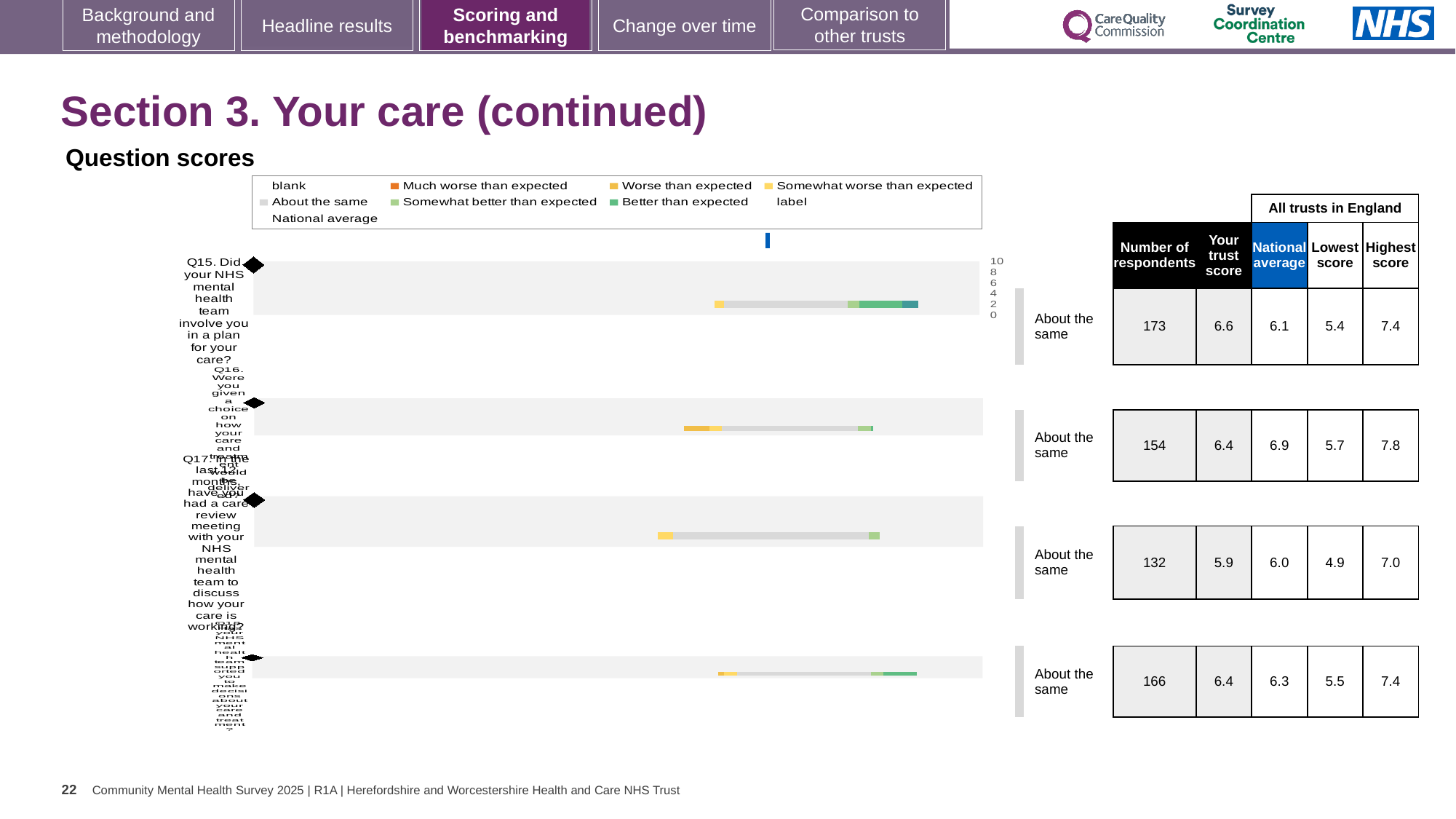
Which question has the highest number of respondents? Q15 How many question rows (bars) are plotted in the chart? 4 By how much does the trust score for Q15 exceed the national average for Q15? 0.5 How many entries does the chart legend list? 9 What is the number of respondents for Q15 (Did your NHS mental health team involve you in a plan for your care?)? 173 What is the national average for Q16? 6.9 Which question has the lowest trust score? Q17 What kind of chart is shown under 'Question scores'? bar chart What is the highest score across all trusts in England for Q16? 7.8 What is the trust score for Q15? 6.6 For Q16, which is larger: the trust score or the national average? national average What is the lowest score across all trusts in England for Q17? 4.9